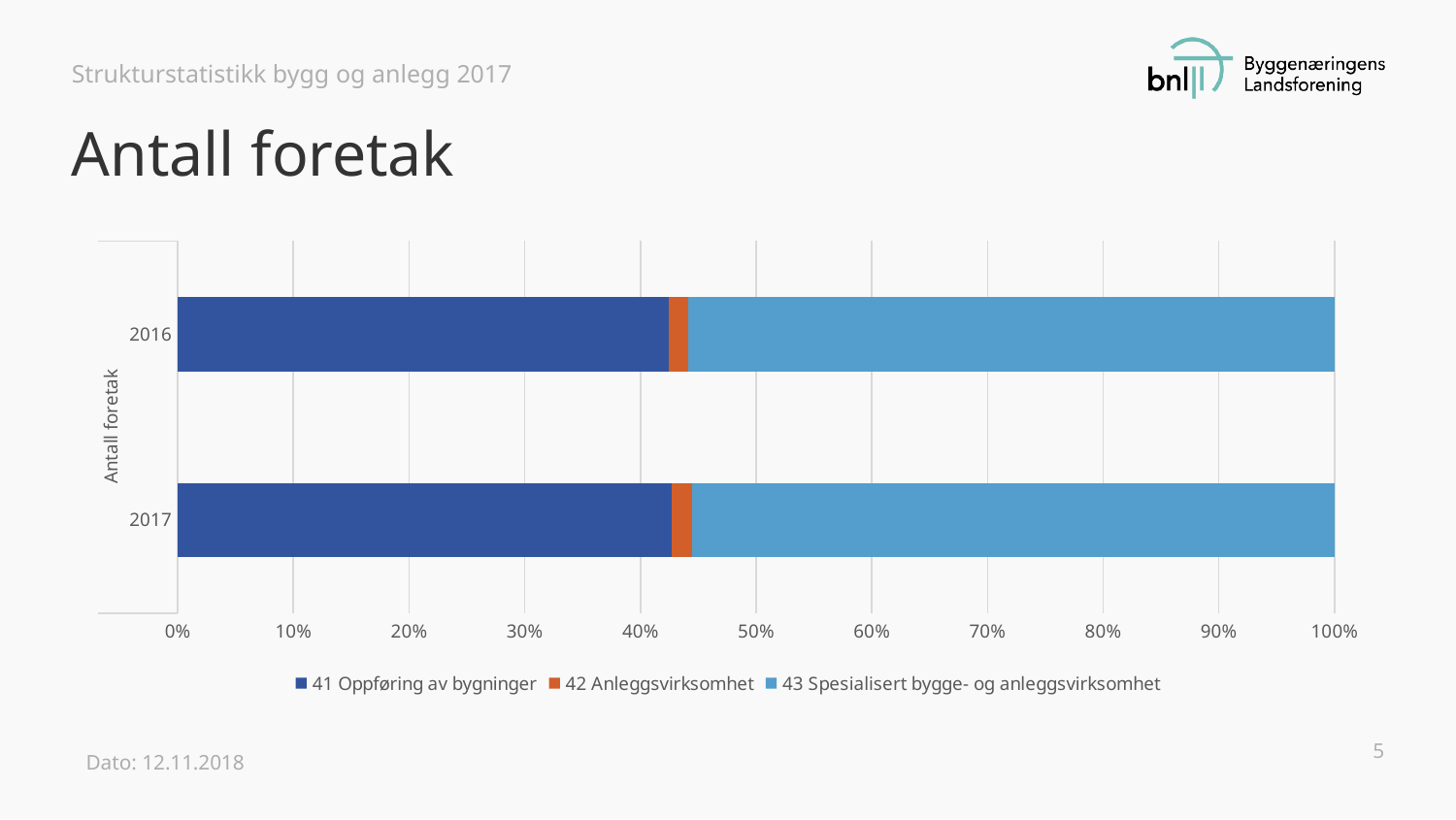
Is the share for 41 Oppføring av bygninger in 2016 greater or less than 40%? greater How many series does the legend list? 3 How many years (categories) are plotted on the chart? 2 Is the share for 41 Oppføring av bygninger in 2017 greater or less than 50%? less What is the total of the stacked bar for 2017? 100% Which series has the smallest share in 2016? 42 Anleggsvirksomhet What kind of chart is shown on the slide? Stacked bar chart What is the title of the chart? Antall foretak Is the share for 42 Anleggsvirksomhet in 2017 greater or less than 10%? less Which series has the largest share in 2017? 43 Spesialisert bygge- og anleggsvirksomhet Which series is shown in orange in the legend? 42 Anleggsvirksomhet